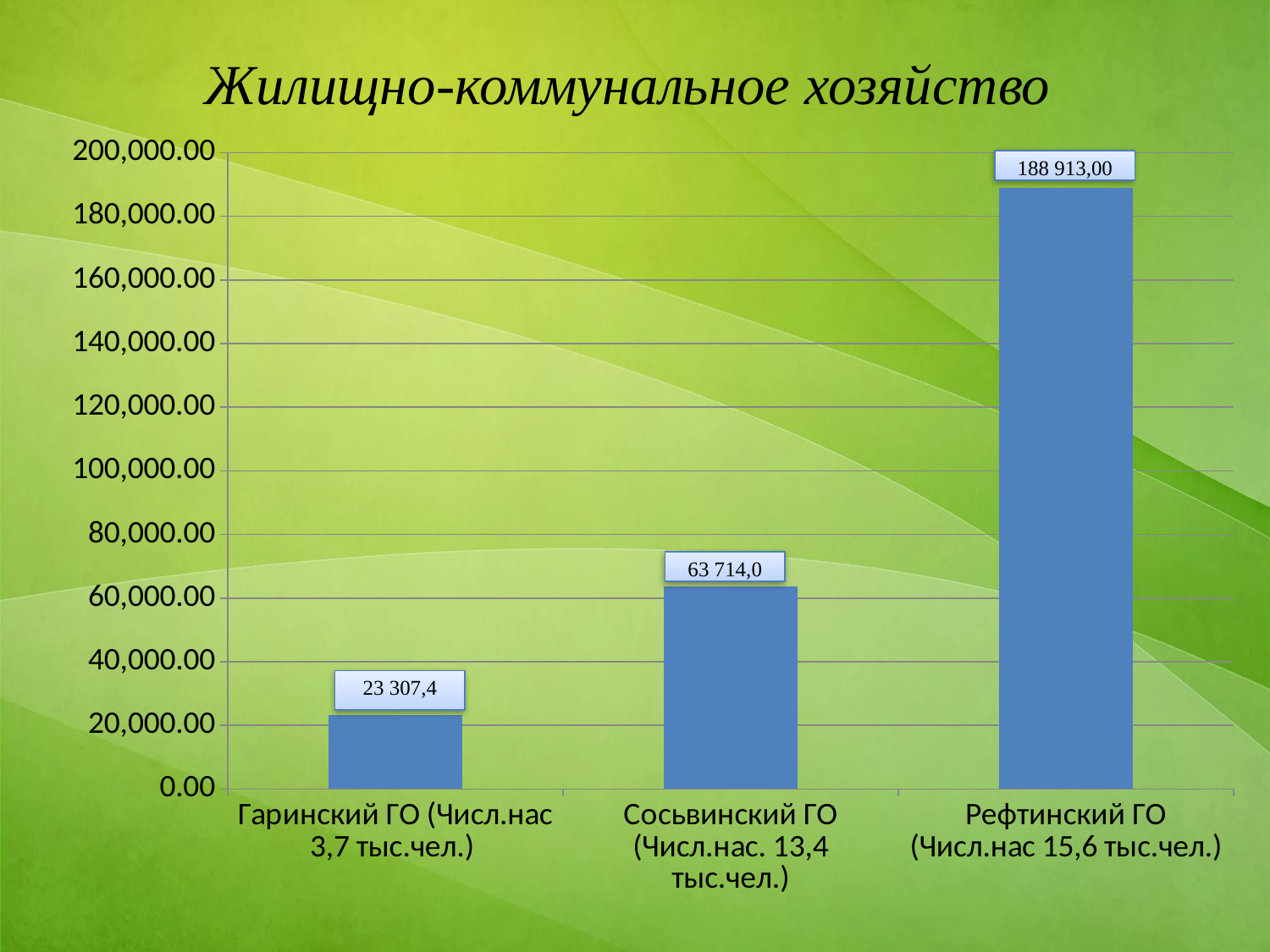
What is the difference between the values for Сосьвинский ГО and Гаринский ГО? 40 406,6 What is the value for Рефтинский ГО? 188 913,00 What kind of chart is shown on the slide? bar chart Is the value for Рефтинский ГО greater or less than 180,000.00? greater What is the value for Сосьвинский ГО? 63 714,0 What is the title of the slide? Жилищно-коммунальное хозяйство Which category has the highest value? Рефтинский ГО What is the value for Гаринский ГО? 23 307,4 Which category has the lowest value? Гаринский ГО Which is larger, the value for Сосьвинский ГО or the value for Гаринский ГО? Сосьвинский ГО How many categories are shown in the chart? 3 What is the difference between the values for Рефтинский ГО and Сосьвинский ГО? 125 199,0